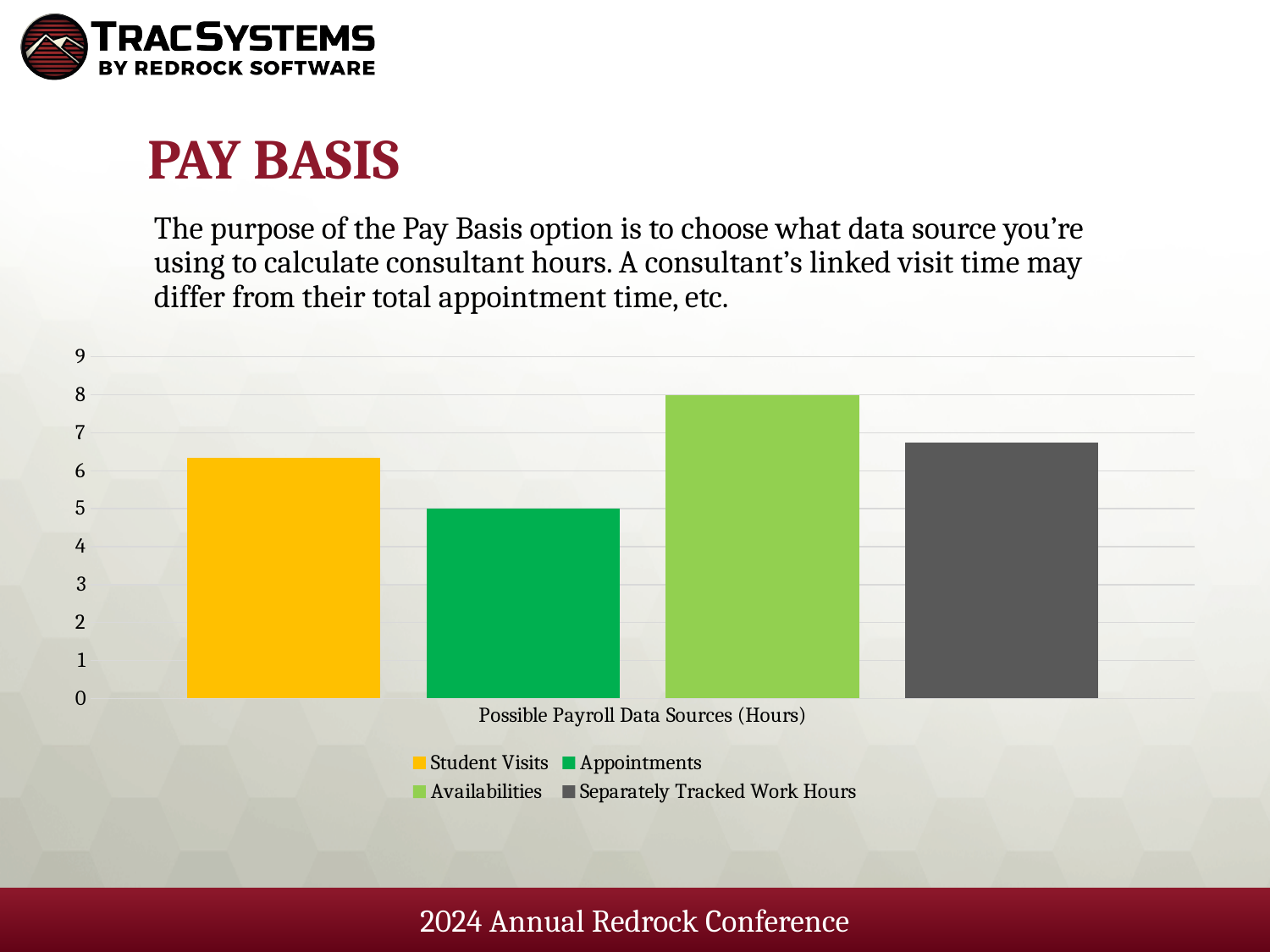
What is the value for Appointments? 5 What kind of chart is shown on the slide? bar chart What is the value for Availabilities? 8 Is the value for Student Visits greater or less than 6? greater Which series has the lowest value? Appointments How many series does the legend list? 4 Which is larger, the value for Availabilities or the value for Student Visits? Availabilities Which is larger, the value for Separately Tracked Work Hours or the value for Appointments? Separately Tracked Work Hours Which series has the highest value? Availabilities What is the title shown on the horizontal axis of the chart? Possible Payroll Data Sources (Hours) What is the difference between the value for Availabilities and the value for Appointments? 3 Is the value for Separately Tracked Work Hours greater or less than 7? less